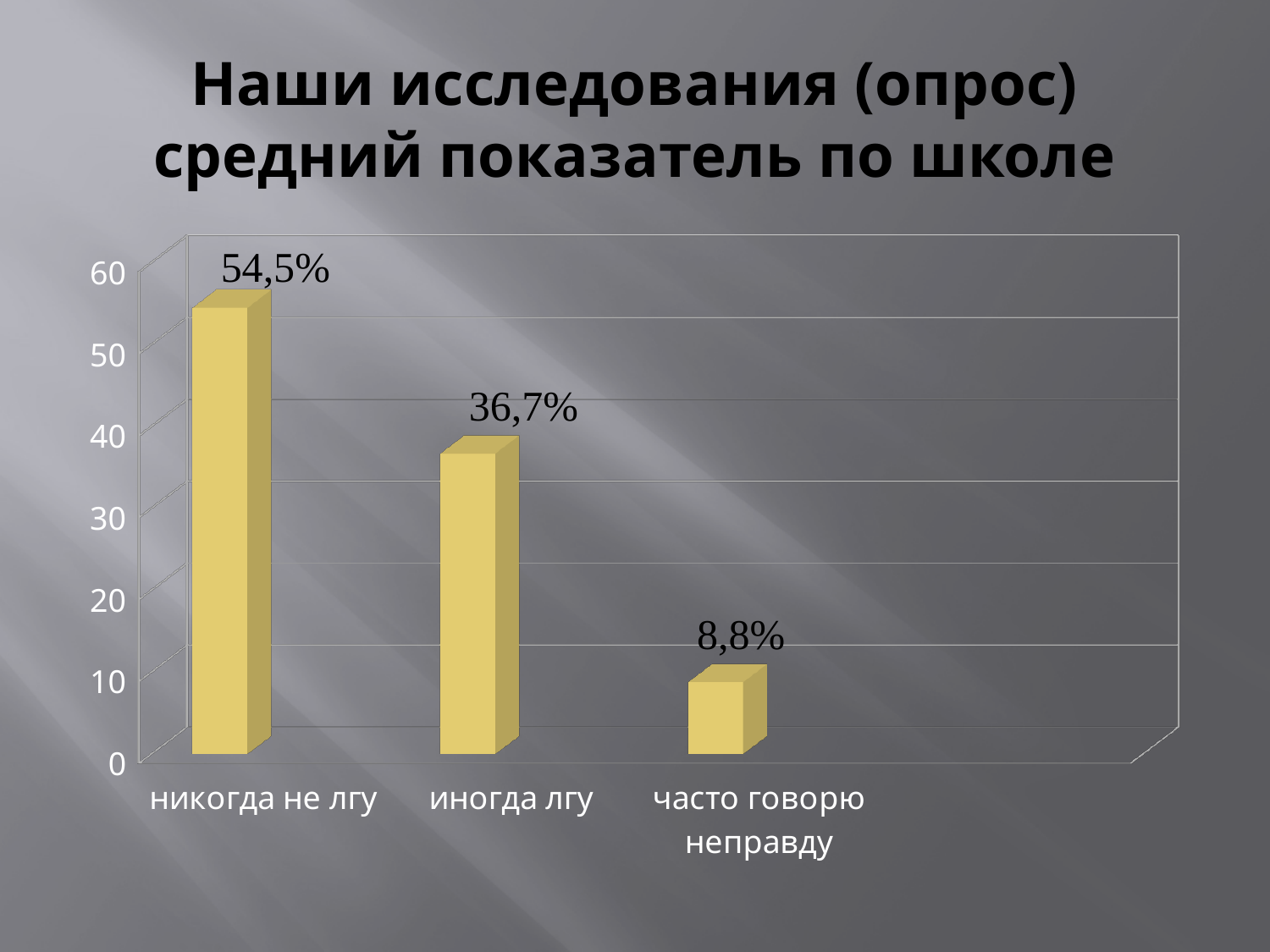
What is the difference between the values for "никогда не лгу" and "иногда лгу"? 17,8% What is the value for "иногда лгу"? 36,7% Which category has the lowest value? часто говорю неправду What is the value for "никогда не лгу"? 54,5% What is the difference between the values for "иногда лгу" and "часто говорю неправду"? 27,9% Do the values rise or fall from left to right along the x axis? fall Which is larger, the value for "иногда лгу" or the value for "часто говорю неправду"? иногда лгу Is the value for "иногда лгу" greater or less than 40? less What kind of chart is shown on the slide? bar chart Which category has the highest value? никогда не лгу What is the value for "часто говорю неправду"? 8,8% How many categories are shown on the chart? 3